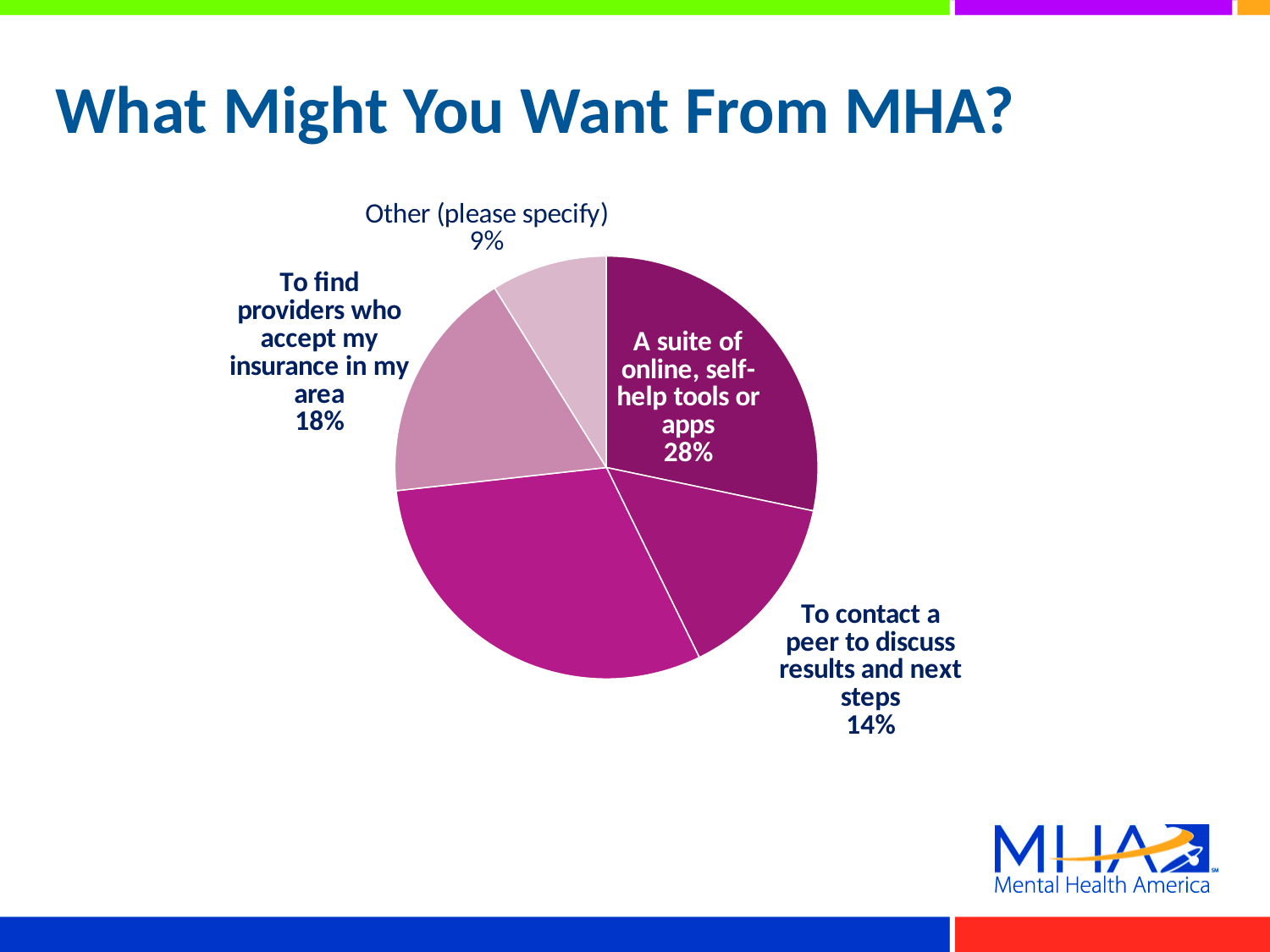
What percentage is shown for "To find providers who accept my insurance in my area"? 18% How many slices does the pie chart have? 5 What percentage is shown for "Other (please specify)"? 9% What percentage is shown for "To contact a peer to discuss results and next steps"? 14% Which is larger: the share for "To find providers who accept my insurance in my area" or the share for "To contact a peer to discuss results and next steps"? To find providers who accept my insurance in my area What is the difference in percentage points between "To find providers who accept my insurance in my area" and "Other (please specify)"? 9 percentage points What share of the pie is for "A suite of online, self-help tools or apps"? 28% What is the title of the slide? What Might You Want From MHA? Which labelled slice has the smallest share of the pie? Other (please specify) Which is larger: the share for "A suite of online, self-help tools or apps" or the share for "To find providers who accept my insurance in my area"? A suite of online, self-help tools or apps What kind of chart is shown on the slide? Pie chart How many percentage points larger is the share for "A suite of online, self-help tools or apps" than the share for "To contact a peer to discuss results and next steps"? 14 percentage points